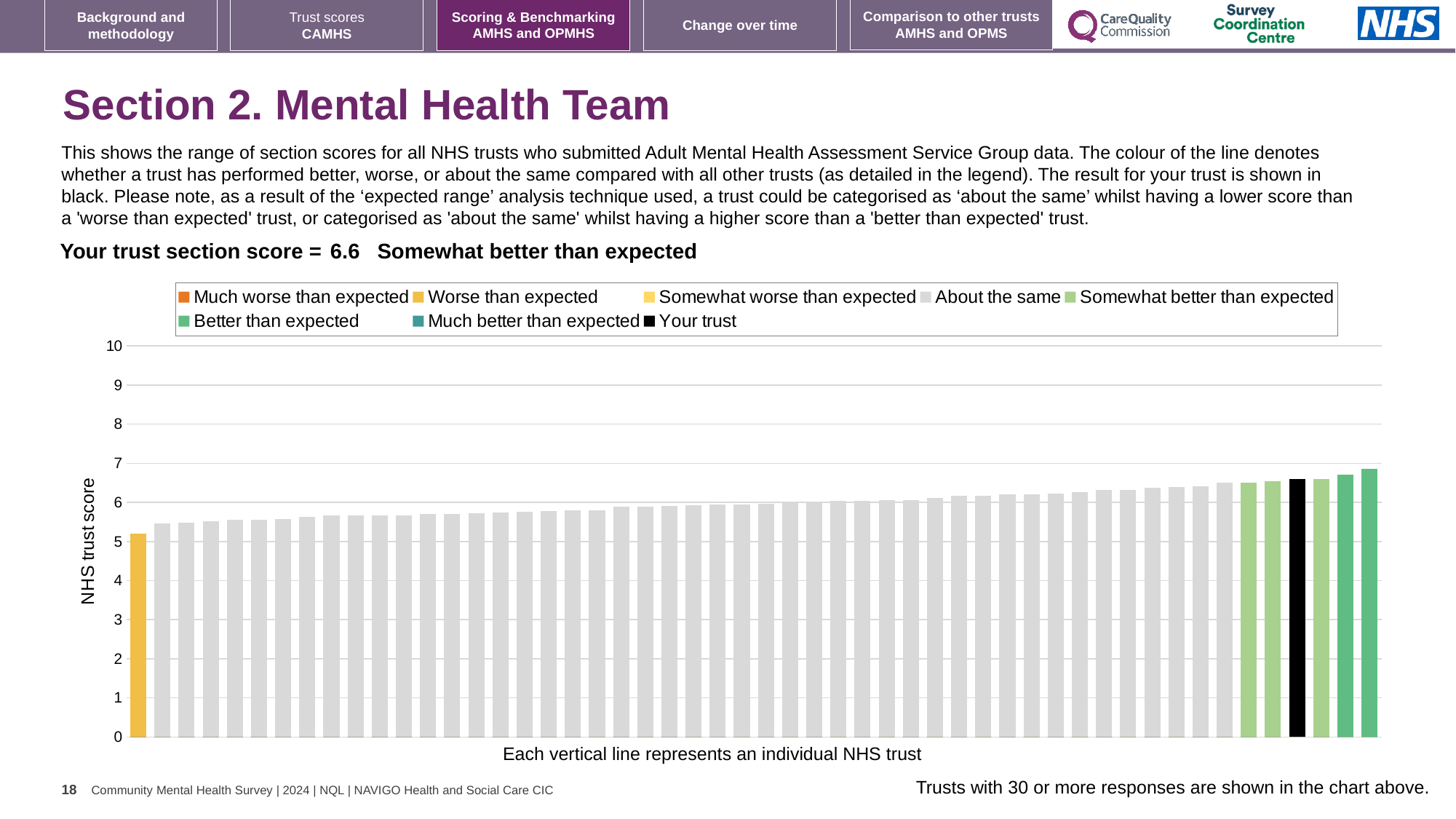
How many entries does the chart legend list? 8 Is the value of the rightmost (highest) bar greater or less than 7? less Is the value of the leftmost (lowest) bar greater or less than 6? less What is the section score for your trust? 6.6 What is the label on the vertical axis of the chart? NHS trust score Is the value for your trust greater or less than 6? greater What colour is the bar representing your trust? black What kind of chart is shown on the slide? bar chart Which legend category does the lowest bar on the chart belong to? Worse than expected Do the bar values rise or fall from left to right along the x axis? rise What is the highest value shown on the vertical axis? 10